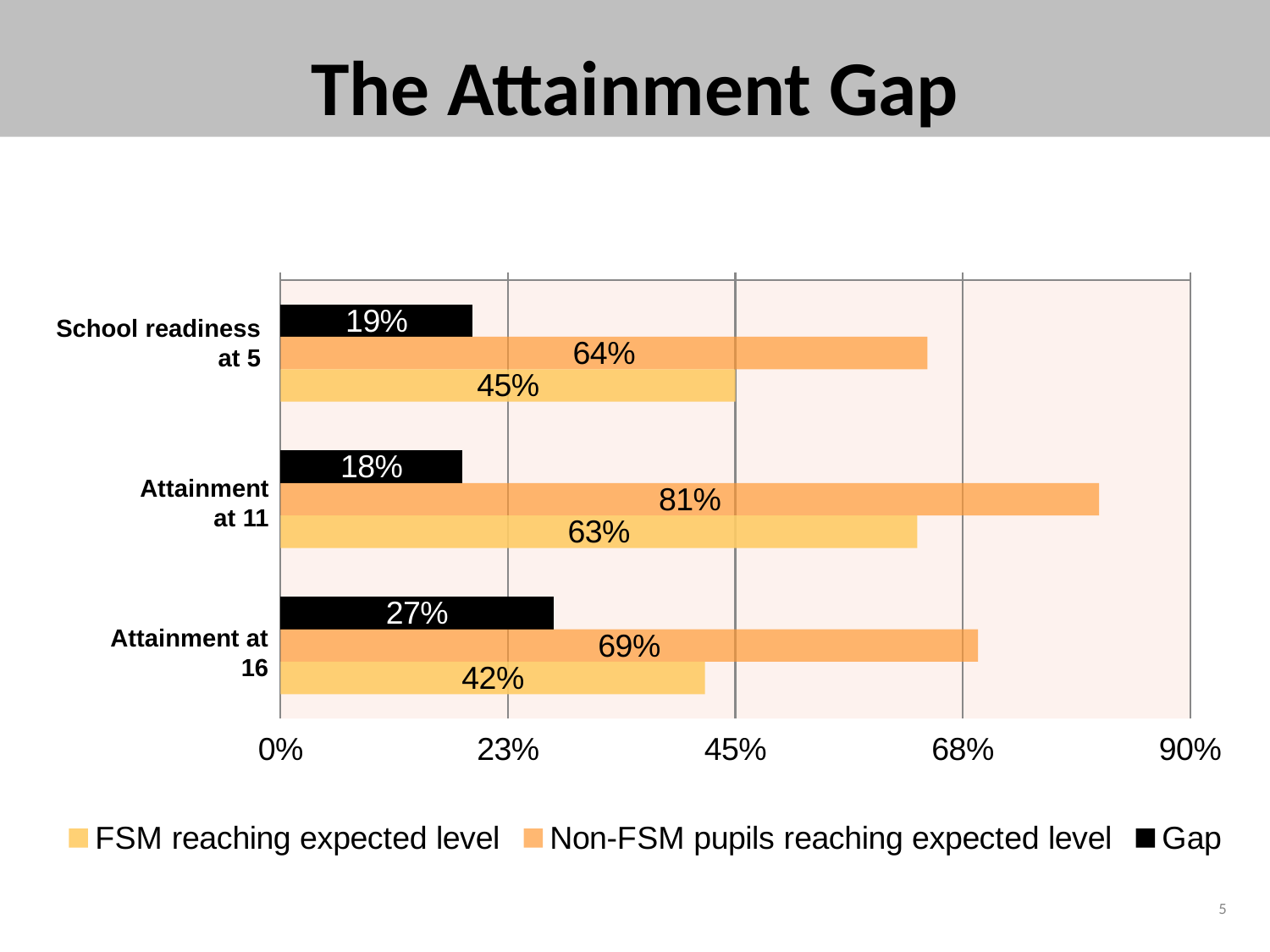
How many categories are shown on the chart? 3 How many series does the legend list? 3 What is the value for Non-FSM pupils reaching expected level at Attainment at 11? 81% What is the difference between Non-FSM pupils reaching expected level and FSM reaching expected level at School readiness at 5? 19% Which category has the lowest value for FSM reaching expected level? Attainment at 16 What is the value for FSM reaching expected level at School readiness at 5? 45% What is the title of the slide? The Attainment Gap Which is larger: the Non-FSM value at Attainment at 11 or the Non-FSM value at Attainment at 16? Attainment at 11 Is the value for Non-FSM pupils reaching expected level at Attainment at 16 greater or less than 45%? greater What is the Gap value for Attainment at 16? 27% Which category has the highest Gap value? Attainment at 16 What kind of chart is shown on the slide? Bar chart